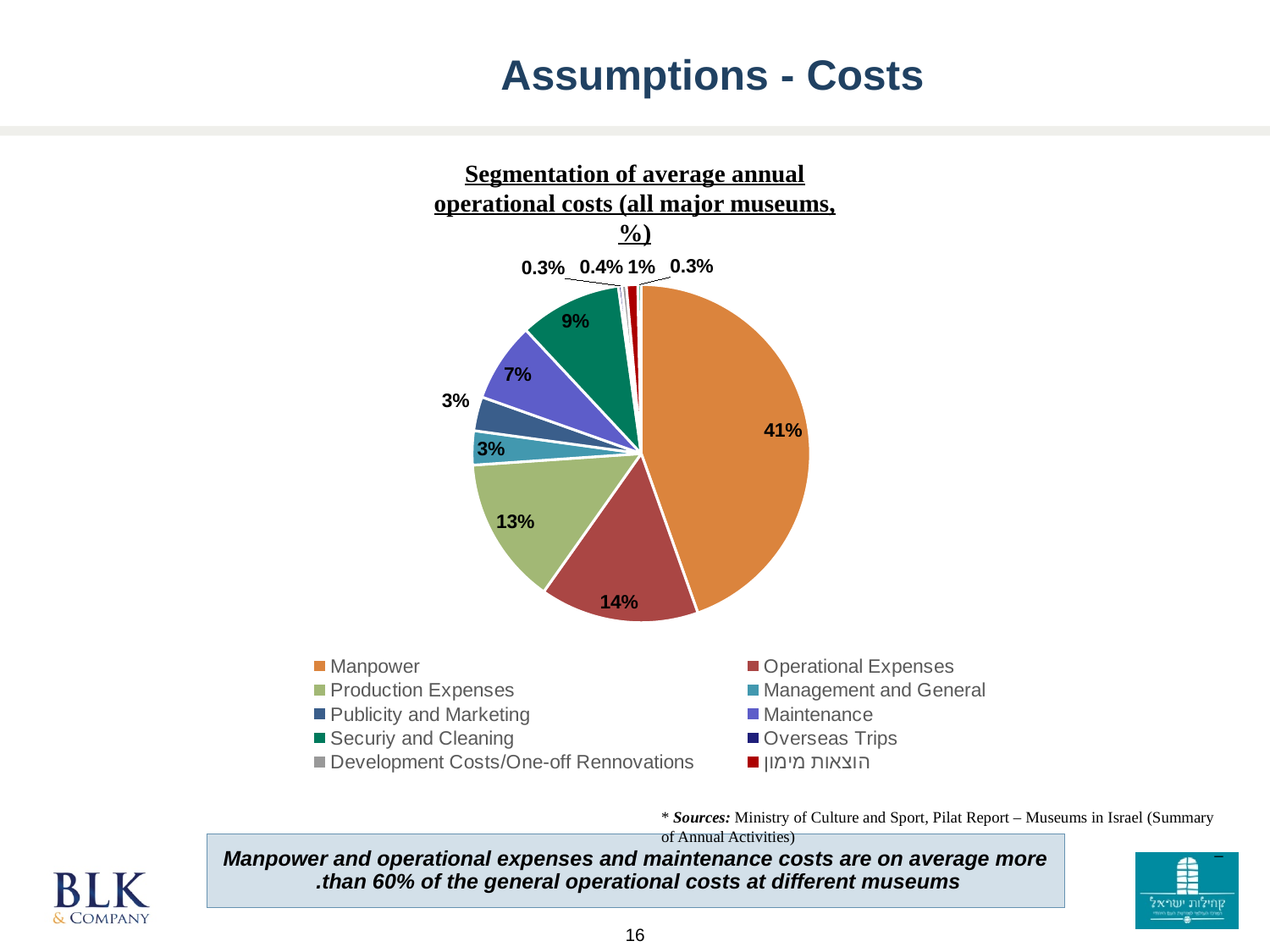
Which has a larger share, Securiy and Cleaning or Operational Expenses? Operational Expenses How many entries does the chart legend list? 10 What share of average annual operational costs is Maintenance? 7% What share of average annual operational costs is Operational Expenses? 14% What share of average annual operational costs is Production Expenses? 13% Which has a larger share, Production Expenses or Maintenance? Production Expenses What kind of chart is shown on the slide? pie chart What colour is the Manpower slice of the pie chart? orange What share of average annual operational costs is Manpower? 41% What is the difference in percentage points between the Manpower share and the Operational Expenses share? 27 What share of average annual operational costs is Securiy and Cleaning? 9% Which category has the largest share of average annual operational costs? Manpower